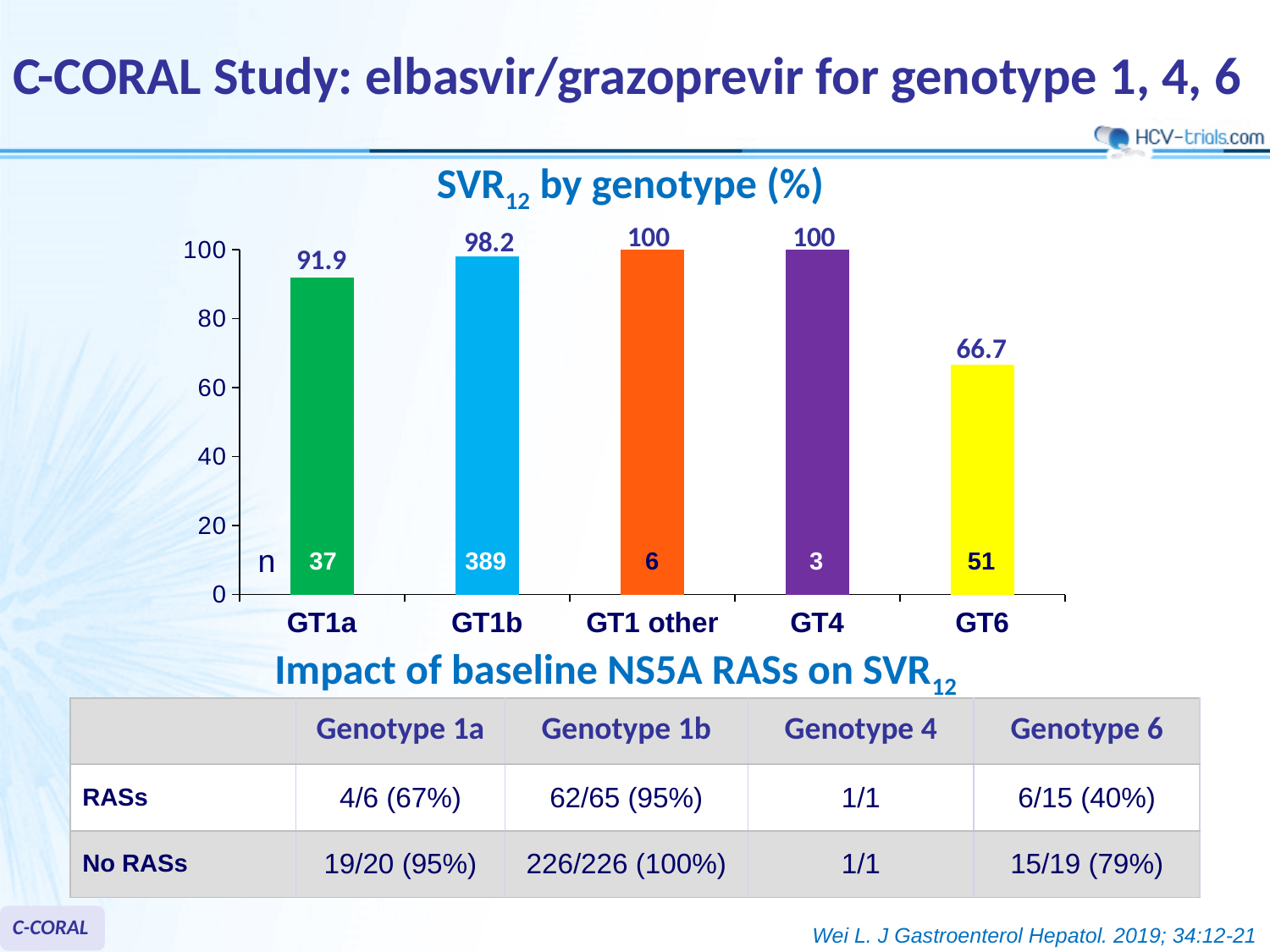
How many genotype categories are shown in the chart? 5 What is the SVR12 value for GT6? 66.7 What is the difference between the SVR12 values for GT1b and GT1a? 6.3 What is the SVR12 value for GT1b? 98.2 Which has a higher SVR12 value, GT1a or GT1b? GT1b What is the difference between the SVR12 values for GT4 and GT6? 33.3 What is the SVR12 value for GT1a? 91.9 What is the n value shown for GT1b? 389 What kind of chart is shown on the slide? bar chart Is the SVR12 value for GT6 greater or less than 80? less What is the title of the chart? SVR12 by genotype (%) Which genotype has the lowest SVR12 value? GT6